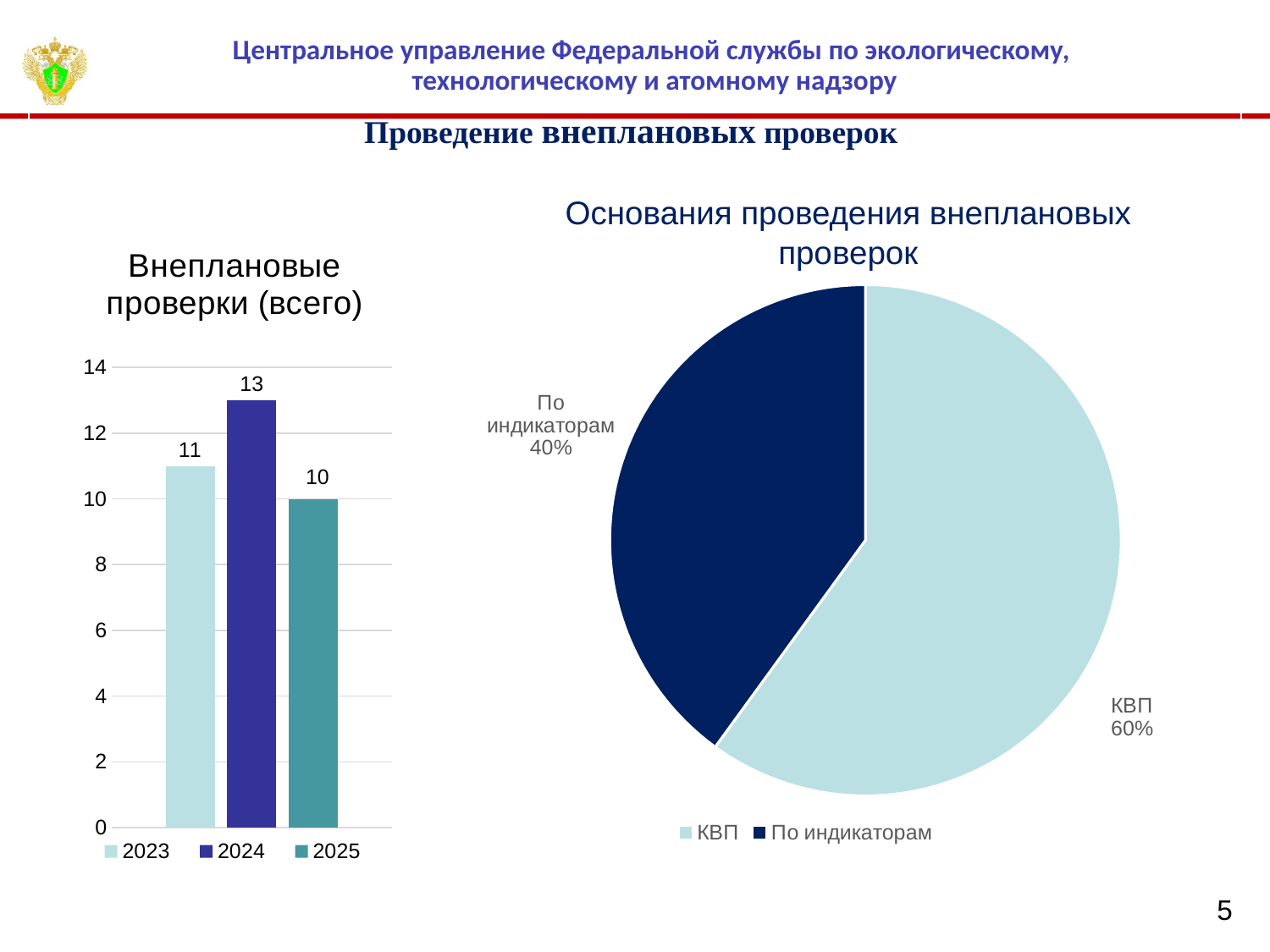
How many entries does the legend of the 'Основания проведения внеплановых проверок' chart list? 2 In the 'Внеплановые проверки (всего)' chart, which is larger, the value for 2023 or the value for 2025? 2023 In the 'Внеплановые проверки (всего)' chart, what is the value for 2023? 11 In the 'Внеплановые проверки (всего)' chart, what is the value for 2024? 13 In the 'Внеплановые проверки (всего)' chart, which year has the lowest value? 2025 In the 'Внеплановые проверки (всего)' chart, what is the difference between the values for 2024 and 2025? 3 In the 'Внеплановые проверки (всего)' chart, how many bars are plotted? 3 In the 'Основания проведения внеплановых проверок' chart, what share does 'КВП' have? 60% What kind of chart is 'Внеплановые проверки (всего)'? Bar chart What kind of chart is 'Основания проведения внеплановых проверок'? Pie chart In the 'Внеплановые проверки (всего)' chart, which year has the highest value? 2024 In the 'Основания проведения внеплановых проверок' chart, what share does 'По индикаторам' have? 40%